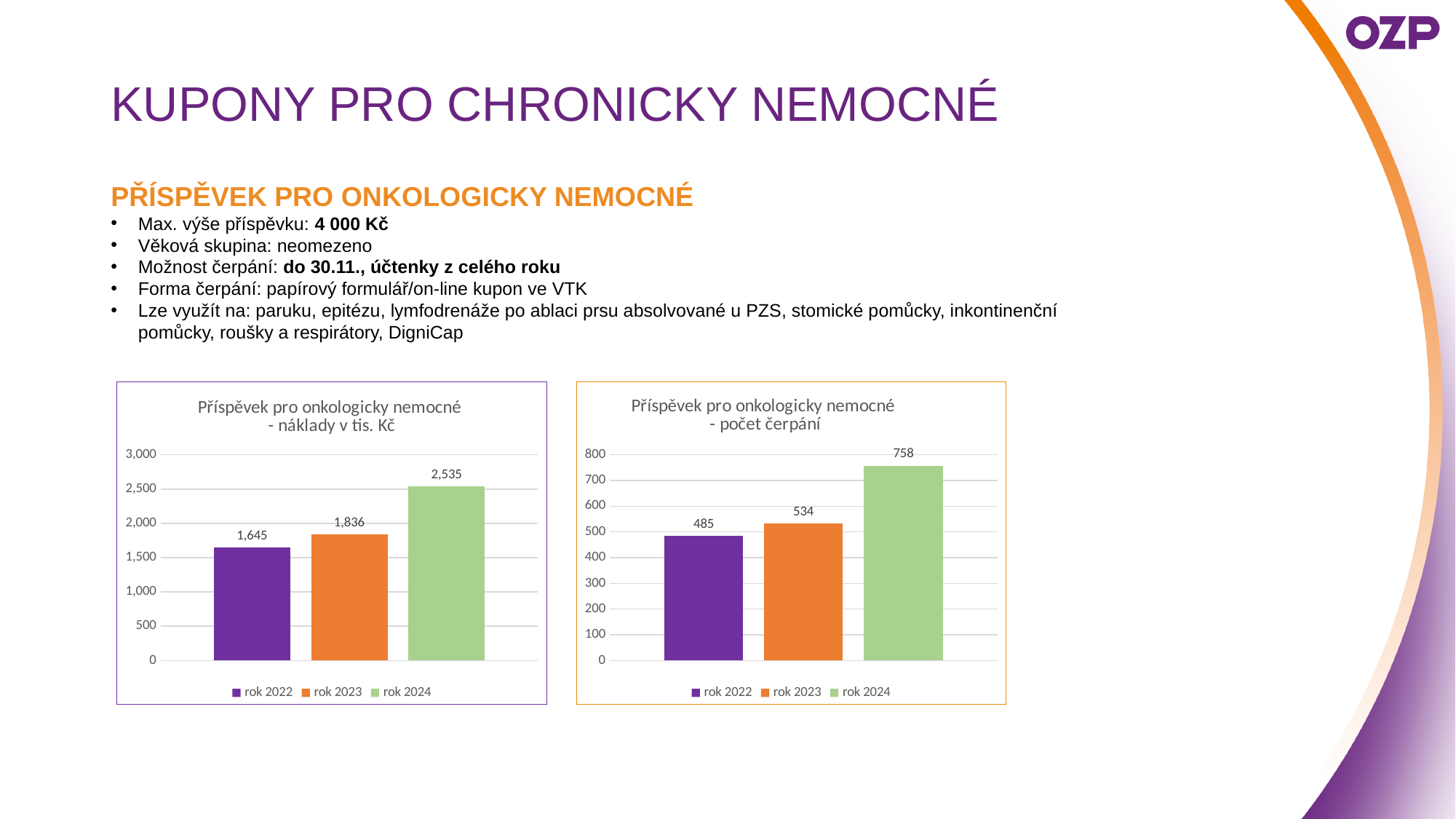
How many bars are plotted in the right chart (počet čerpání)? 3 In the right chart (počet čerpání), what is the difference between rok 2023 and rok 2022? 49 In the right chart (počet čerpání), what is the value for rok 2024? 758 How many series does the legend of the left chart (náklady v tis. Kč) list? 3 In the left chart (náklady v tis. Kč), what is the value for rok 2023? 1,836 In the left chart (náklady v tis. Kč), what is the difference between rok 2024 and rok 2022? 890 In the right chart (počet čerpání), which is larger: rok 2023 or rok 2024? rok 2024 In the left chart (náklady v tis. Kč), which year has the highest value? rok 2024 What kind of chart is the left chart (náklady v tis. Kč)? bar chart In the right chart (počet čerpání), which year has the lowest value? rok 2022 In the left chart (náklady v tis. Kč), is the value for rok 2022 greater or less than 2,000? less In the right chart (počet čerpání), do the values rise or fall from rok 2022 to rok 2024? rise